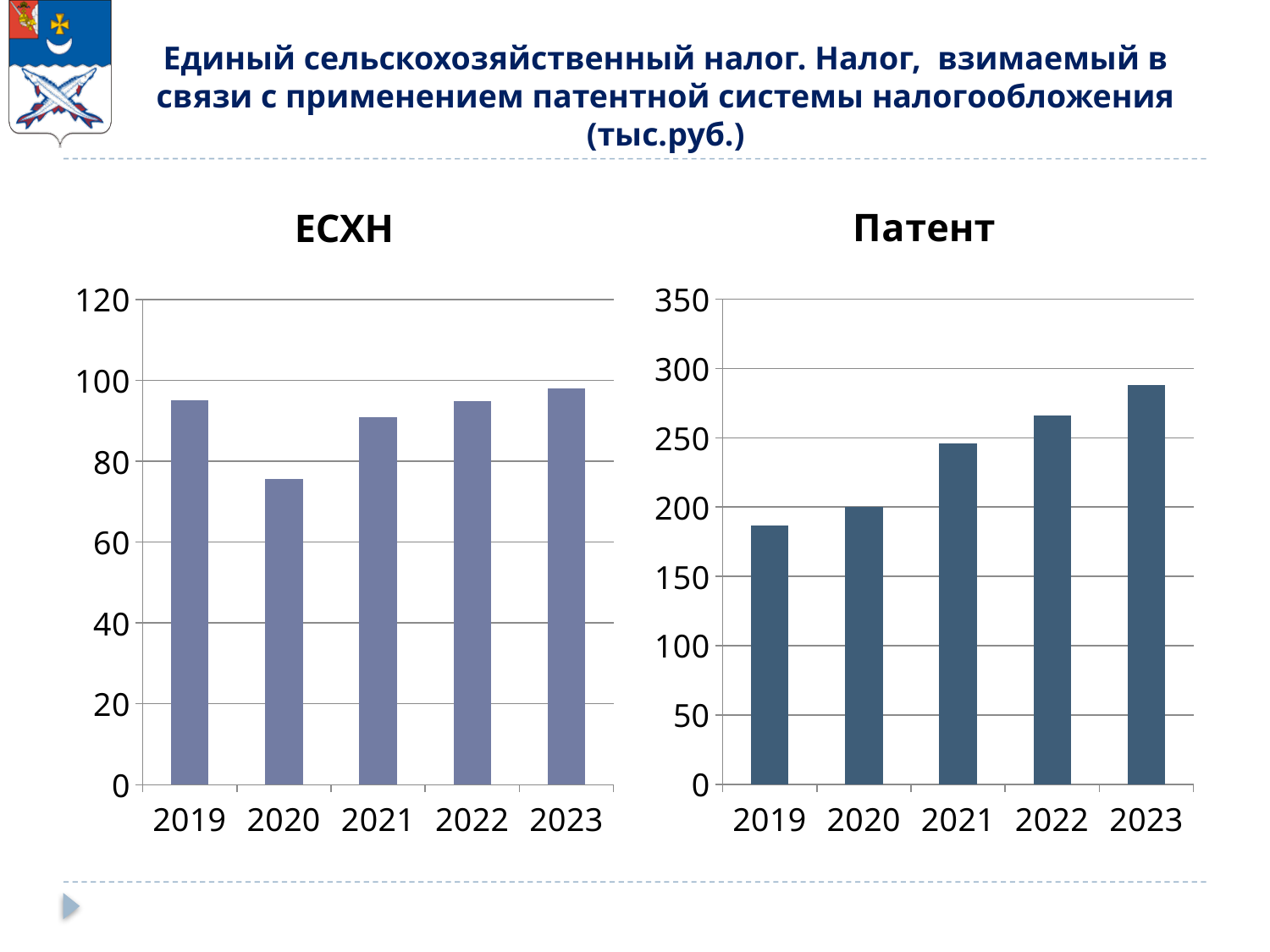
On the ЕСХН chart, is the value for 2020 greater or less than 80? less On the Патент chart, do the values rise or fall from 2019 to 2023? rise On the Патент chart, is the value for 2019 greater or less than 200? less On the Патент chart, is the value for 2023 greater or less than 250? greater On the ЕСХН chart, which is larger, the value for 2021 or the value for 2020? 2021 How many years are shown on the Патент chart? 5 What kind of chart is the ЕСХН chart? bar chart On the Патент chart, which is larger, the value for 2022 or the value for 2020? 2022 On the Патент chart, which year has the highest value? 2023 On the ЕСХН chart, which year has the lowest value? 2020 On the Патент chart, which year has the lowest value? 2019